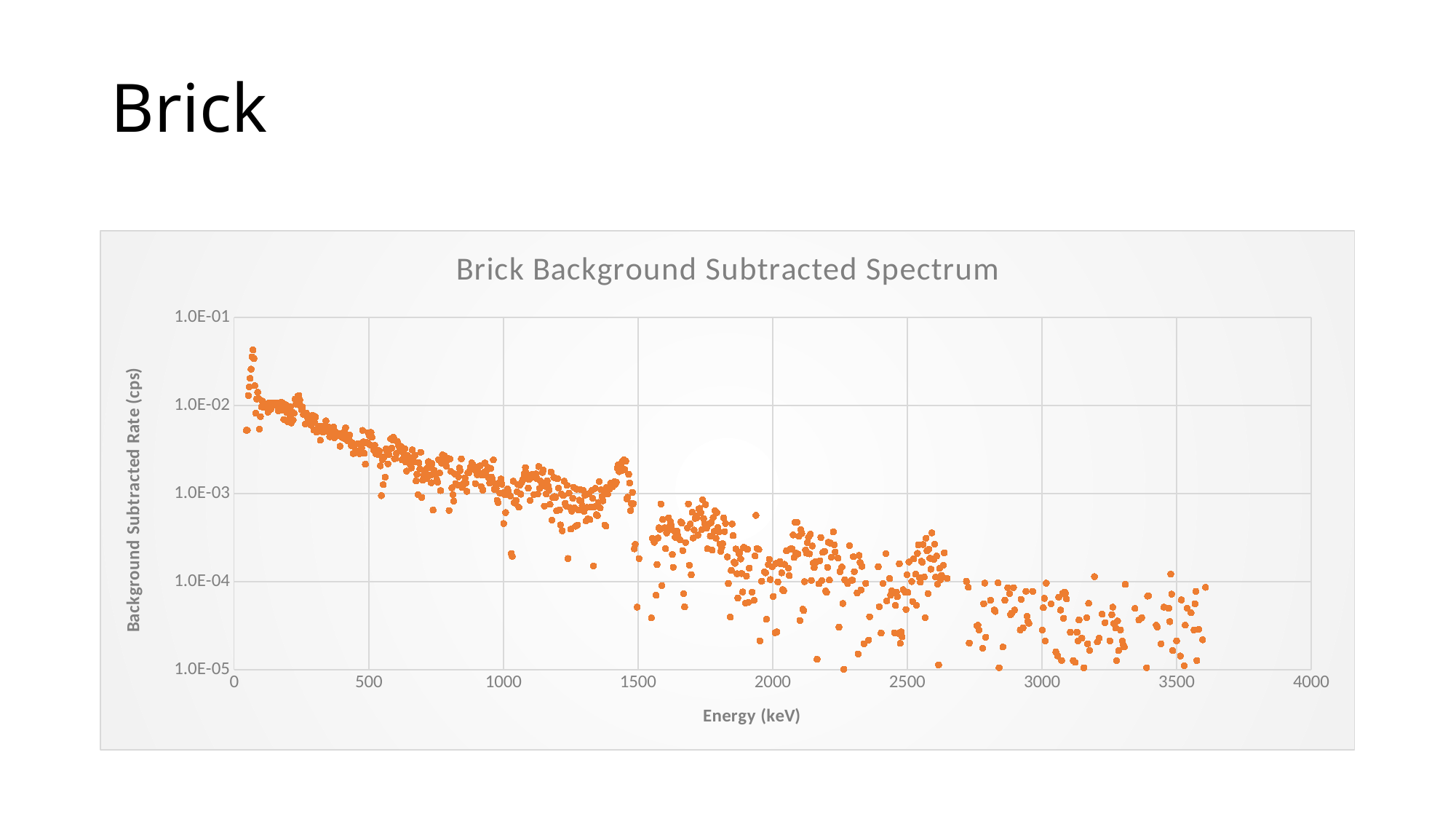
Do the plotted values generally rise or fall as energy increases along the x axis? Fall Is the highest plotted value on the chart greater or less than 1.0E-02 cps? greater What kind of chart is shown on the slide? Scatter plot What is the label of the x axis of the chart? Energy (keV) What is the title of the chart? Brick Background Subtracted Spectrum Are the values plotted near 100 keV greater or less than 1.0E-03 cps? greater Are the values plotted near 500 keV greater or less than 1.0E-03 cps? greater Are the values plotted near 100 keV larger or smaller than those plotted near 3000 keV? larger In which energy region are the plotted values higher: around 500 keV or around 2500 keV? around 500 keV